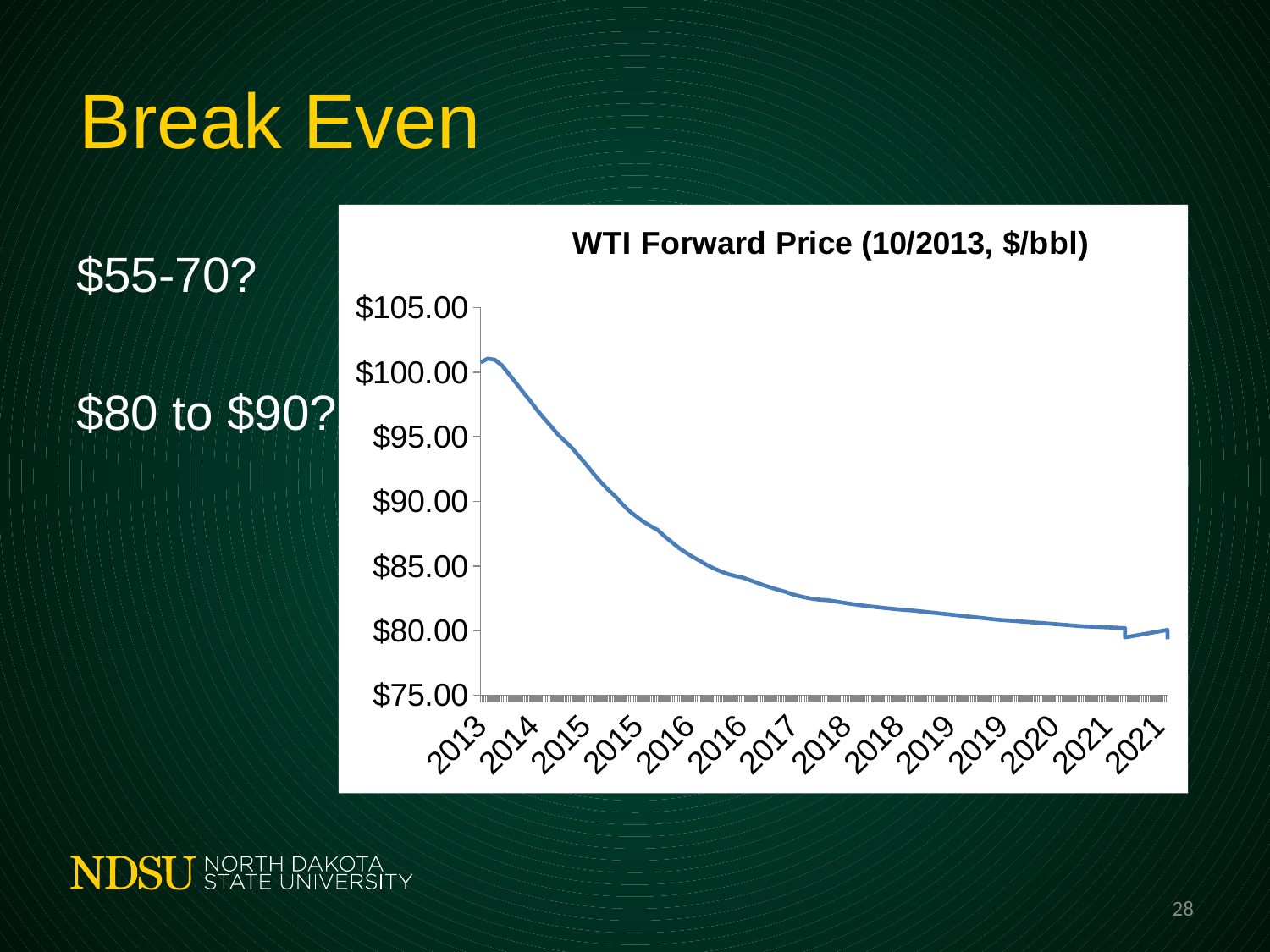
How many lines are plotted on the chart? 1 Does the WTI forward price rise or fall from 2013 to 2021 along the x axis? fall Is the WTI forward price in 2021 greater or less than $85.00? less Is the WTI forward price at the start of 2013 greater or less than $95.00? greater What kind of chart is shown on the slide? line chart What is the title of the chart? WTI Forward Price (10/2013, $/bbl) In which year on the x axis is the WTI forward price lowest? 2021 What is the highest value shown on the y axis of the chart? $105.00 Which is larger, the WTI forward price in 2014 or in 2019? 2014 Is the WTI forward price at the first 2015 tick greater or less than $85.00? greater In which year on the x axis is the WTI forward price highest? 2013